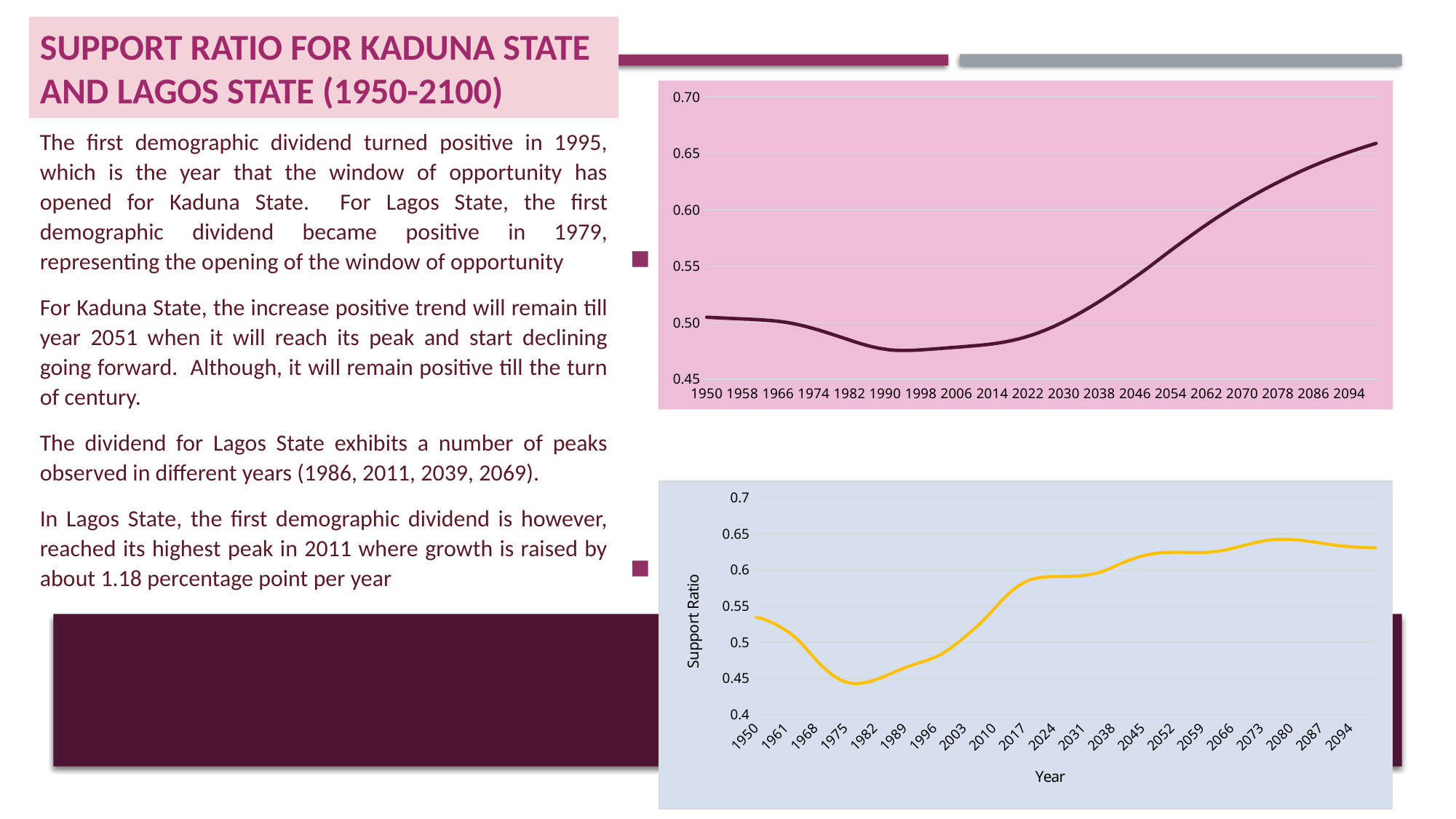
In the top chart, is the value for 2054 greater or less than 0.55? greater In the top chart, do the values rise or fall between 2006 and 2094? rise In the bottom chart, which is larger, the value for 1950 or the value for 2080? 2080 In the bottom chart, is the value for 1975 greater or less than 0.5? less In the bottom chart, do the values rise or fall between 1982 and 2017? rise What is the title of the vertical axis in the bottom chart? Support Ratio In the top chart, is the value for 1990 greater or less than 0.50? less In the top chart, do the values rise or fall between 1950 and 1990? fall What kind of chart is the top chart on the slide? line chart What kind of chart is the bottom chart on the slide? line chart